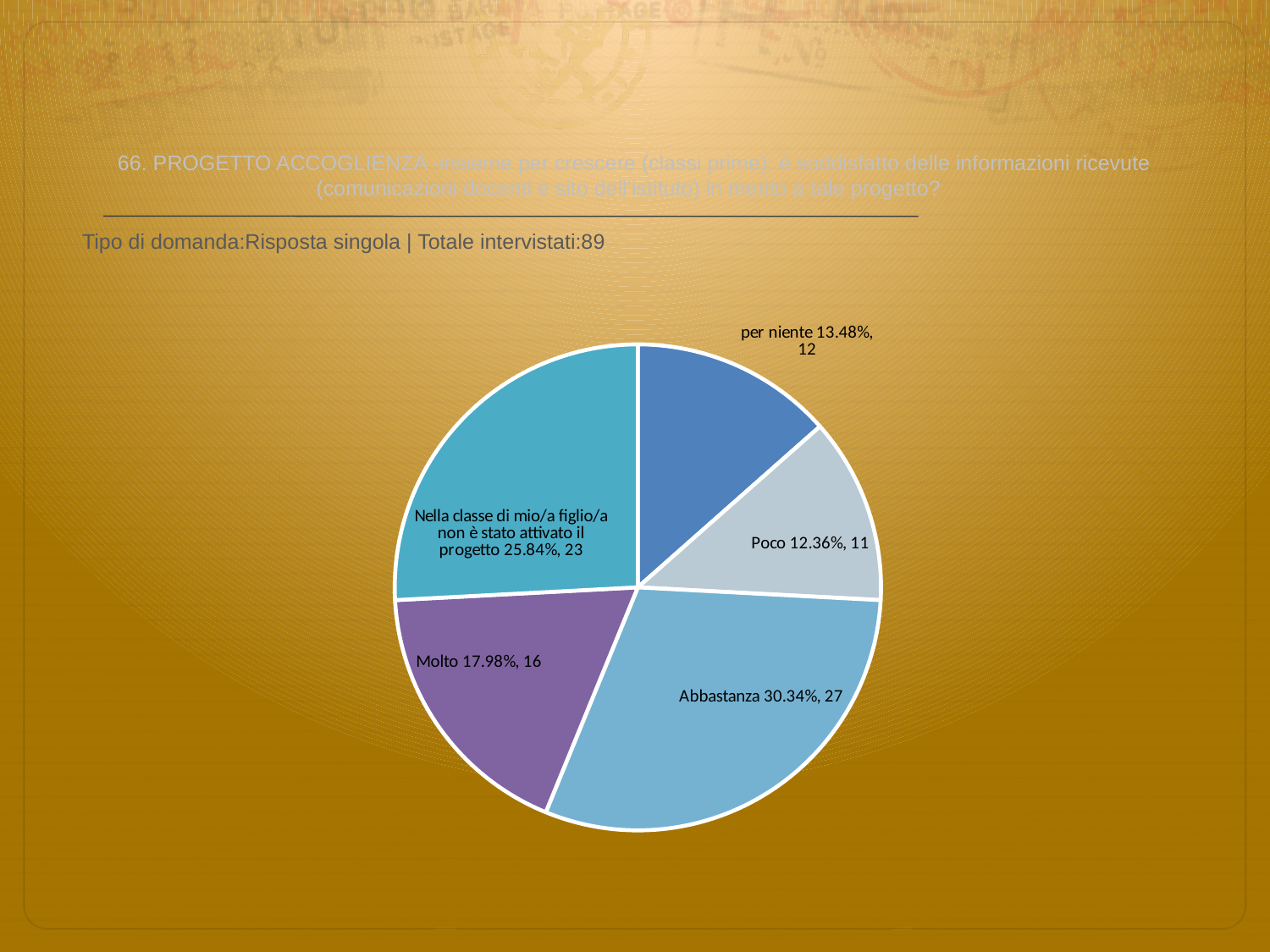
What is the count for the "Poco" slice? 11 Which category has the smallest slice? Poco Which category has the largest slice? Abbastanza What is the count for the "Abbastanza" slice? 27 What percentage share does the "Molto" slice have? 17.98% What is the total number of respondents (Totale intervistati) stated on the slide? 89 What percentage share does the "per niente" slice have? 13.48% What is the difference in count between "Abbastanza" and "Molto"? 11 What kind of chart is shown on the slide? pie chart Which is larger, the count for "Nella classe di mio/a figlio/a non è stato attivato il progetto" or the count for "Molto"? Nella classe di mio/a figlio/a non è stato attivato il progetto How many slices does the pie chart have? 5 What percentage share does the "Nella classe di mio/a figlio/a non è stato attivato il progetto" slice have? 25.84%